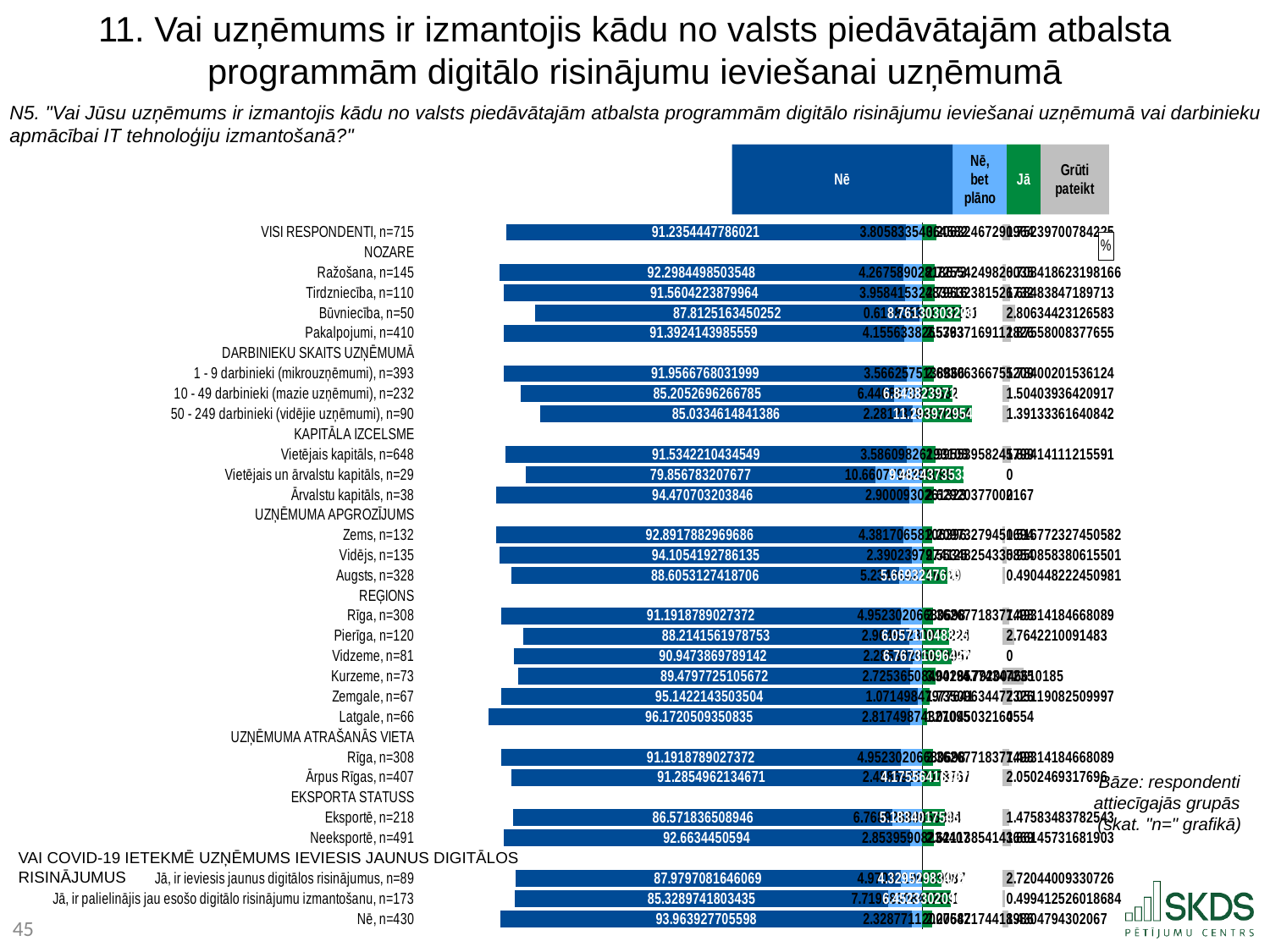
Which category has the lowest value in the "Nē" series? Vietējais un ārvalstu kapitāls, n=29 How many series does the legend list? 4 Which has a larger "Nē" value: Eksportē, n=218 or Neeksportē, n=491? Neeksportē, n=491 Which has a larger "Nē" value: Ražošana, n=145 or Būvniecība, n=50? Ražošana, n=145 What is the value of the "Nē" series for Vietējais un ārvalstu kapitāls, n=29? 79.856783207677 Which category has the highest value in the "Nē" series? Latgale, n=66 Which colour represents the "Jā" series in the legend? Green What is the value of the "Nē" series for VISI RESPONDENTI, n=715? 91.2354447786021 What kind of chart is shown on the slide? Stacked horizontal bar chart What is the value of the "Nē" series for Latgale, n=66? 96.1720509350835 What is the value of the "Nē" series for Eksportē, n=218? 86.571836508946 What is the difference between the "Nē" values for Latgale, n=66 and Zemgale, n=67? 1.0298365847331